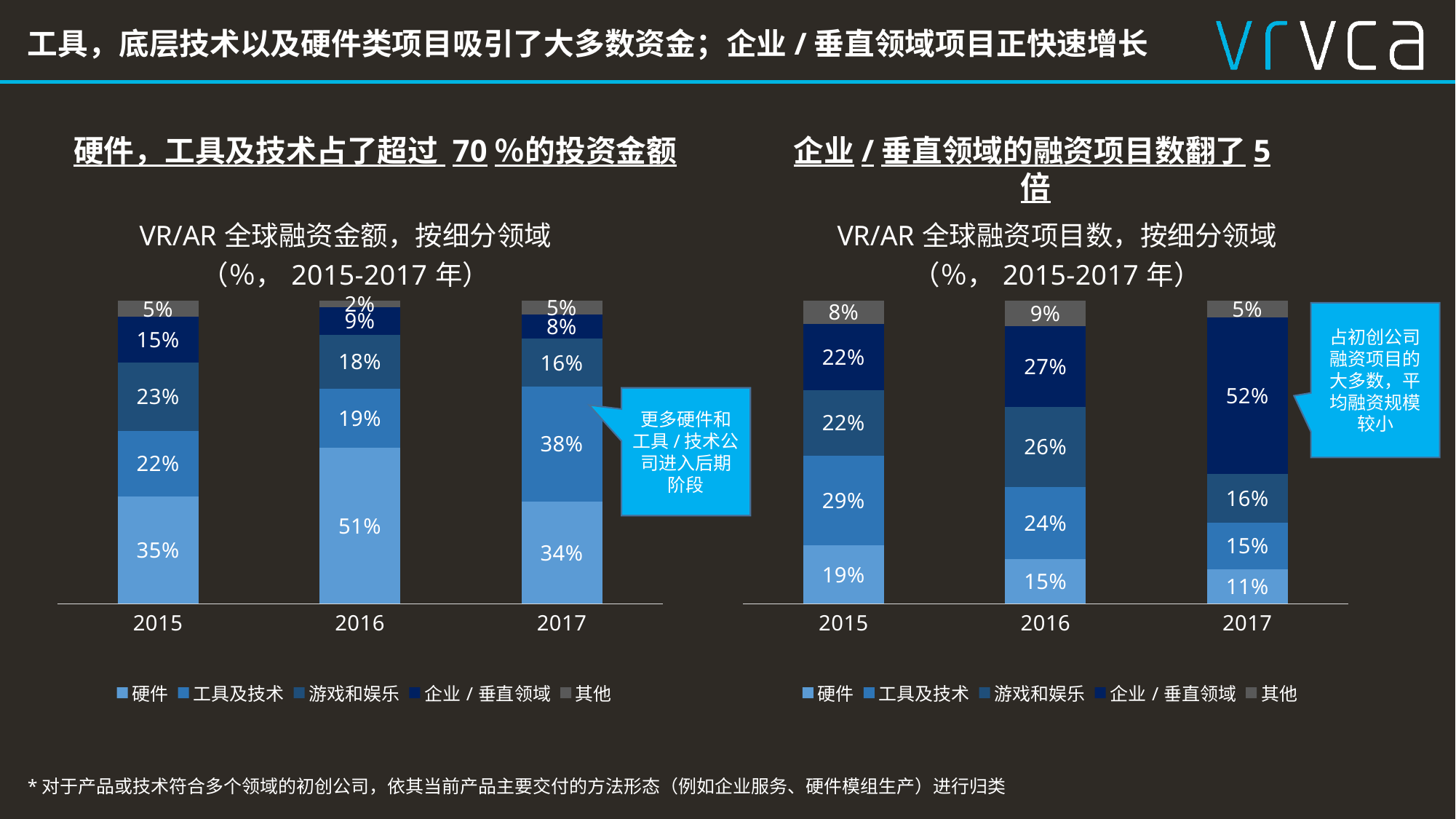
In the right chart (VR/AR 全球融资项目数，按细分领域), what is the value for 企业 / 垂直领域 in 2017? 52% In the left chart (VR/AR 全球融资金额，按细分领域), what is the value for 工具及技术 in 2017? 38% In the right chart (VR/AR 全球融资项目数，按细分领域), which year has the lowest value for 硬件? 2017 In the left chart (VR/AR 全球融资金额，按细分领域), which year has the highest value for 硬件? 2016 In the left chart (VR/AR 全球融资金额，按细分领域), what is the value for 硬件 in 2016? 51% In the right chart (VR/AR 全球融资项目数，按细分领域), does the value for 硬件 rise or fall from 2015 to 2017? Fall How many series does the legend of the right chart (VR/AR 全球融资项目数，按细分领域) list? 5 How many years are shown on the x axis of the left chart (VR/AR 全球融资金额，按细分领域)? 3 In the left chart (VR/AR 全球融资金额，按细分领域), what is the difference between the 工具及技术 values for 2017 and 2016? 19% What kind of chart is the left chart (VR/AR 全球融资金额，按细分领域)? Stacked bar chart In the right chart (VR/AR 全球融资项目数，按细分领域), what is the value for 硬件 in 2015? 19% In the right chart (VR/AR 全球融资项目数，按细分领域), is the 企业 / 垂直领域 value larger in 2016 or in 2017? 2017